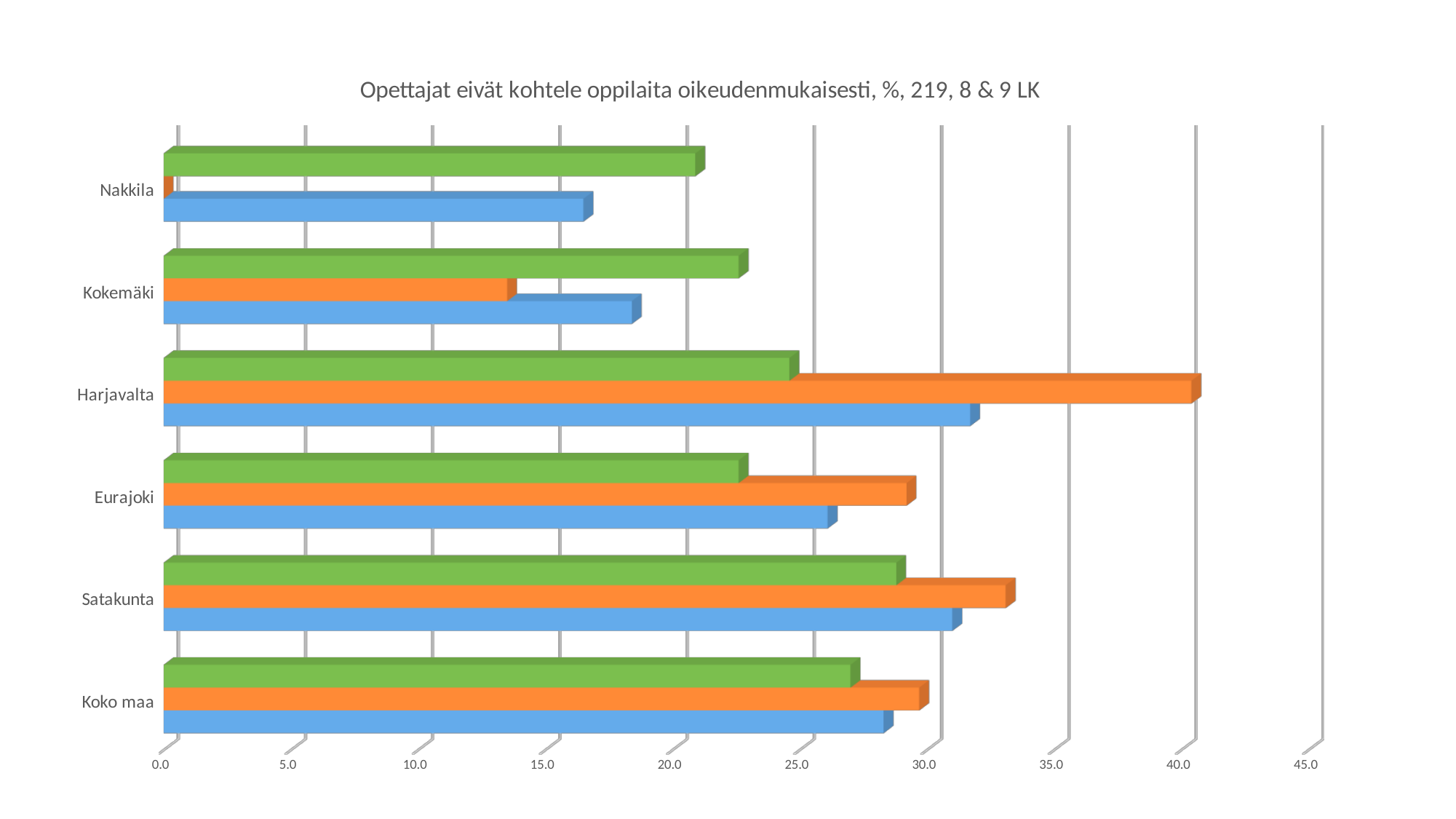
What is the highest value shown on the horizontal axis? 45.0 What is the title of the chart? Opettajat eivät kohtele oppilaita oikeudenmukaisesti, %, 219, 8 & 9 LK Which category has the shortest orange bar? Nakkila How many categories are shown on the vertical axis of the chart? 6 Is the blue bar for Nakkila greater or less than 20.0? less Which is larger for Harjavalta, the orange bar or the blue bar? the orange bar Is the orange bar for Kokemäki greater or less than 15.0? less Which category has the longest orange bar? Harjavalta Is the green bar for Satakunta greater or less than 25.0? greater Which is larger for Nakkila, the green bar or the blue bar? the green bar What kind of chart is shown on the slide? bar chart